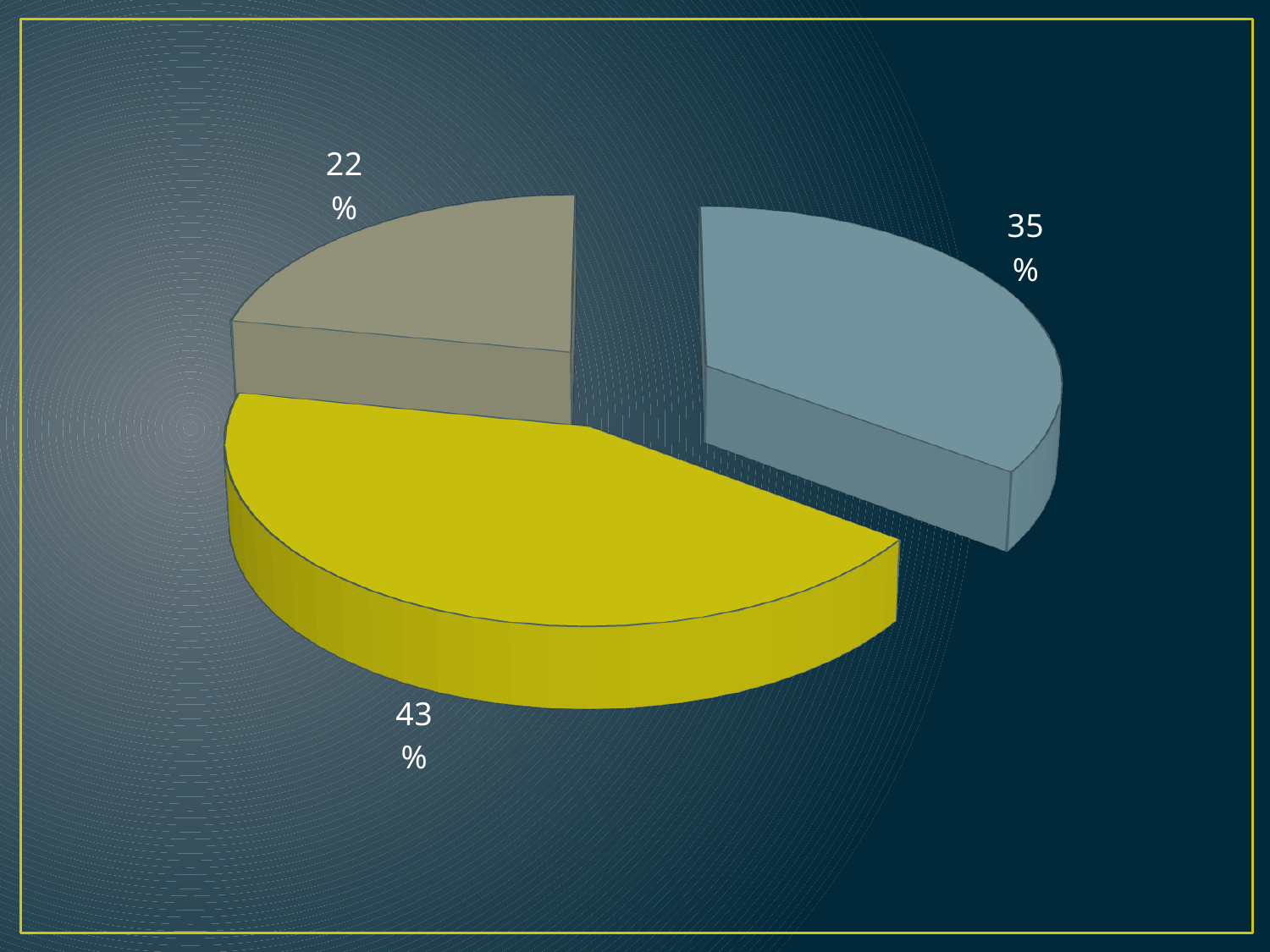
What percentage is shown for the blue-grey slice of the pie chart? 35% How many slices does the pie chart have? 3 What percentage is shown for the yellow slice of the pie chart? 43% What is the difference between the largest and smallest slices of the pie chart? 21% Does the pie chart have a legend? No What kind of chart is shown on the slide? pie chart What is the difference between the yellow slice and the blue-grey slice? 8% Which slice of the pie chart is the largest? the yellow slice (43%) What do the three slice percentages add up to? 100% Which is larger, the blue-grey slice or the beige slice? the blue-grey slice What percentage is shown for the beige slice of the pie chart? 22% Which slice of the pie chart is the smallest? the beige slice (22%)